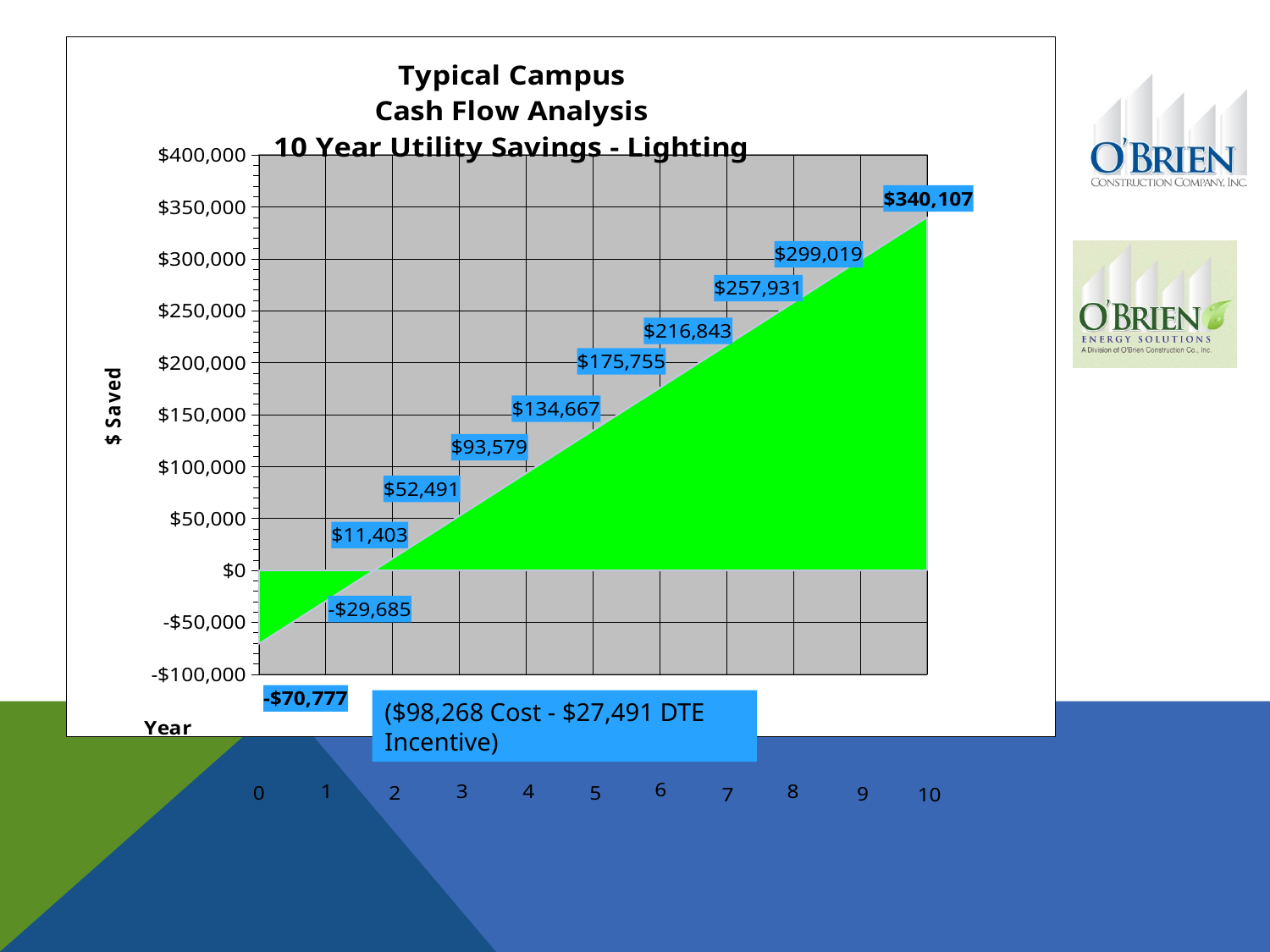
What is the $ Saved value at year 5? $134,667 Which year has the lowest $ Saved value? 0 What is the label of the vertical axis? $ Saved Do the $ Saved values rise or fall as the year increases? rise What is the $ Saved value at year 0? -$70,777 What is the $ Saved value at year 2? $11,403 How many years (data points) are plotted on the chart? 11 Is the $ Saved value at year 8 greater or less than $250,000? greater What is the difference between the $ Saved values at year 10 and year 9? $41,088 Which is larger, the $ Saved value at year 3 or at year 7? Year 7 Which year has the highest $ Saved value? 10 What is the cumulative $ Saved value at year 10? $340,107